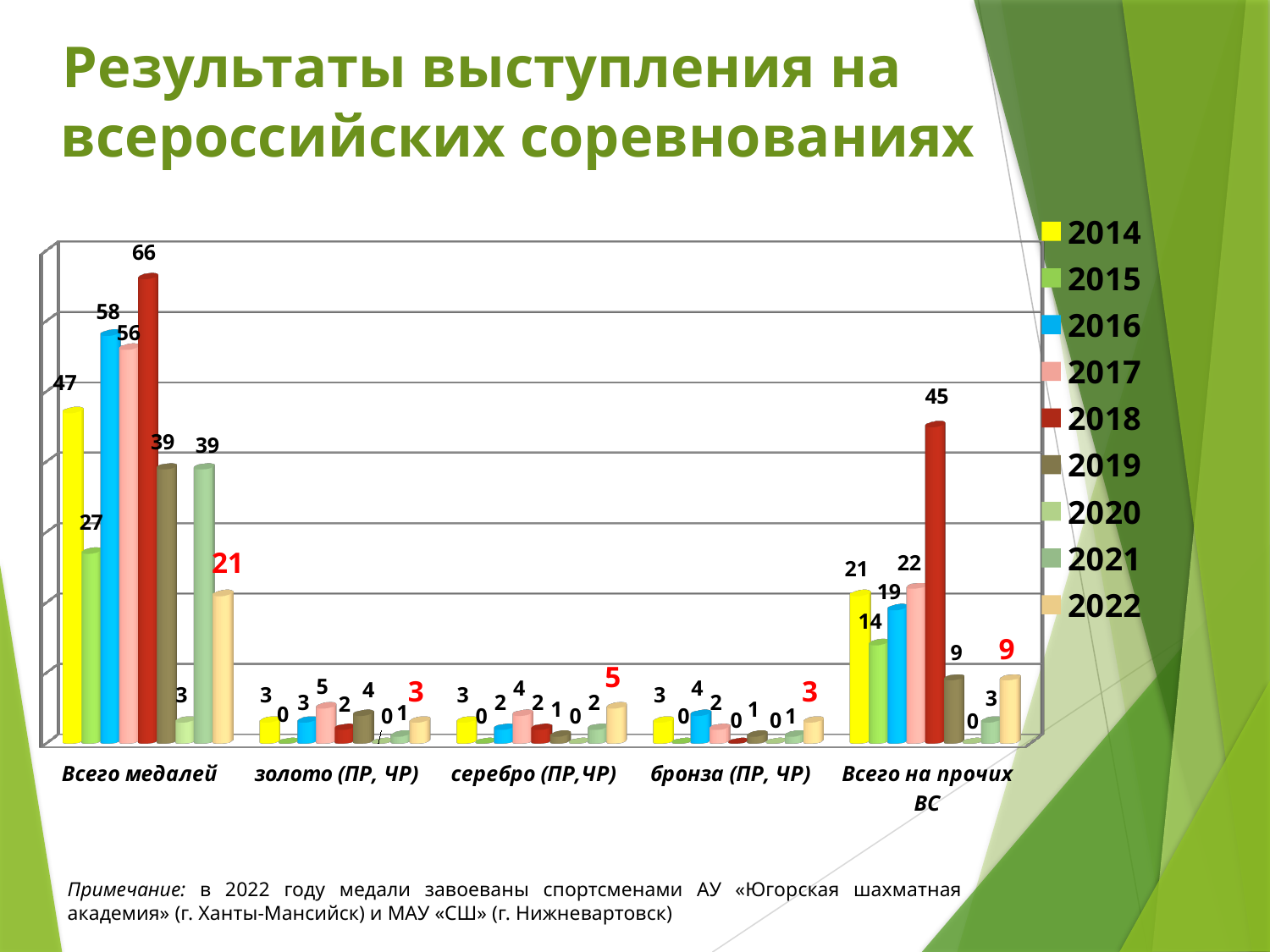
Which year is shown in red in the legend? 2018 Which year has the lowest value in the "Всего медалей" category? 2020 What is the value for 2022 in the "Всего на прочих ВС" category? 9 What is the value for 2022 in the "серебро (ПР,ЧР)" category? 5 What kind of chart is shown on the slide? bar chart What is the difference between the 2018 and 2022 values in the "Всего медалей" category? 45 How many series does the legend list? 9 What is the value for 2018 in the "Всего медалей" category? 66 What is the value for 2017 in the "золото (ПР, ЧР)" category? 5 In the "Всего на прочих ВС" category, which is larger: the value for 2016 or the value for 2017? 2017 How many categories are shown on the x axis? 5 Which year has the highest value in the "Всего медалей" category? 2018